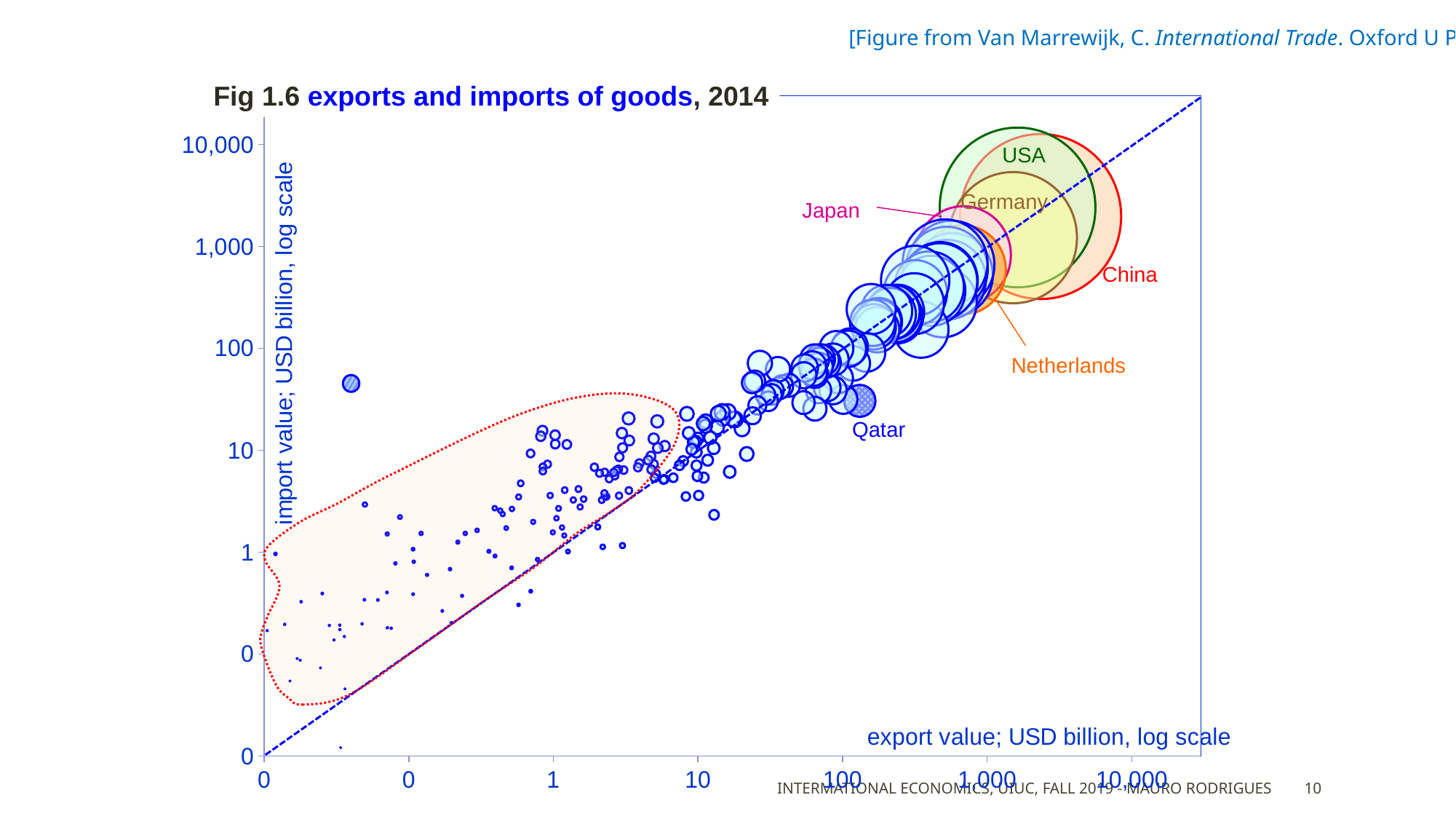
Do import values generally rise or fall as export values increase along the x axis? rise Which has the larger export value, China or Qatar? China Is the import value for Qatar greater or less than 100? less Is the export value for Qatar greater or less than 10? greater How many countries are labelled by name on the chart? 6 Is the export value for China greater or less than 1,000? greater What does the vertical axis of the chart measure? import value; USD billion, log scale What kind of chart is shown on the slide? scatter (bubble) chart Among the labelled countries, which has the lowest import value? Qatar Which has the larger import value, USA or Qatar? USA What is the title of the chart? Fig 1.6 exports and imports of goods, 2014